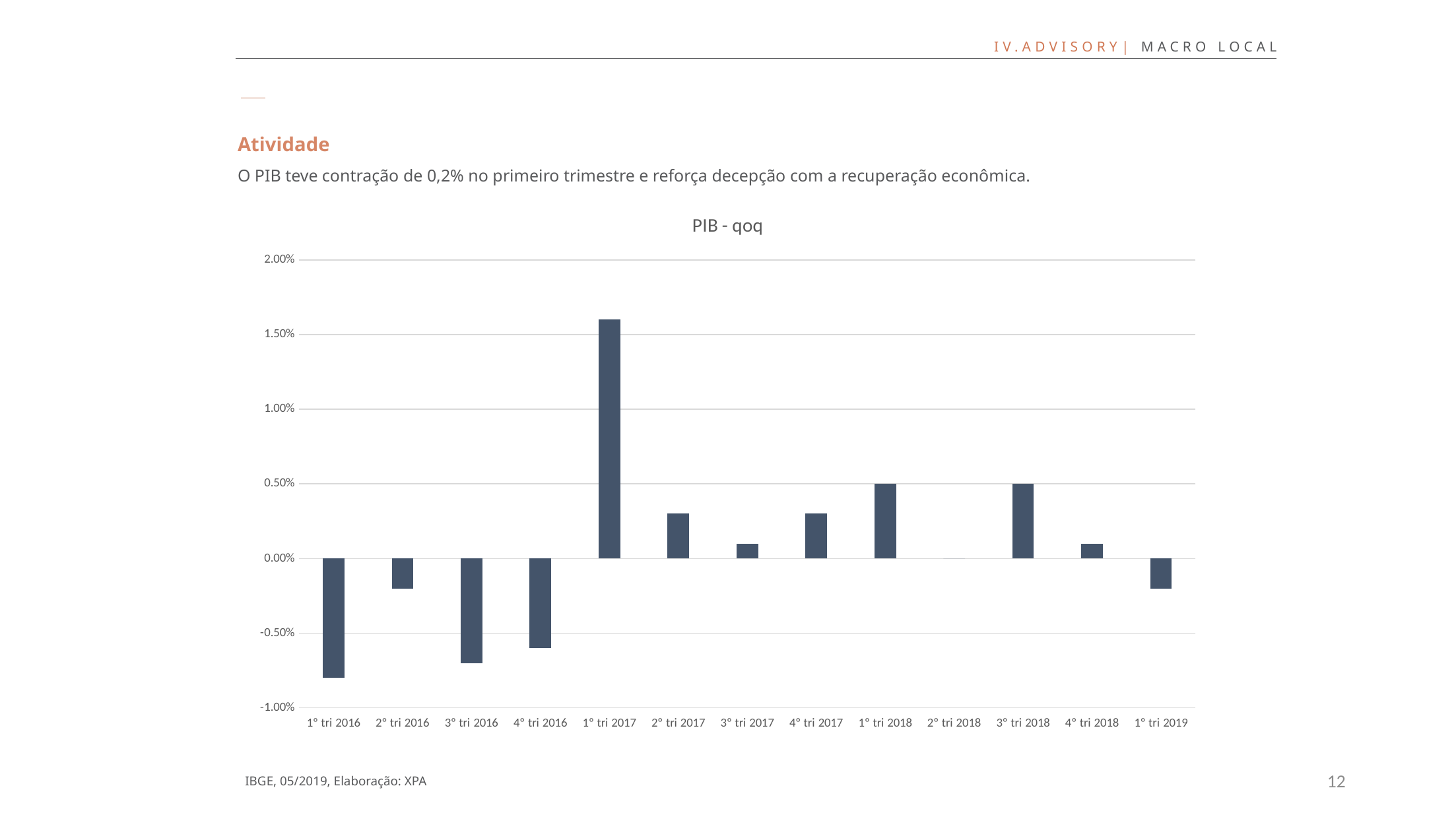
What is the value for 3° tri 2018? 0.50% Is the value for 1° tri 2016 greater or less than -0.50%? less Is the value for 1° tri 2017 greater or less than 1.50%? greater Which is larger, the value for 2° tri 2016 or the value for 3° tri 2016? 2° tri 2016 What type of chart is shown on the slide? bar chart Is the value for 2° tri 2017 greater or less than 0.50%? less What is the title of the chart? PIB - qoq Which quarter has the lowest value in the chart? 1° tri 2016 What is the value for 1° tri 2018? 0.50% Which quarter has the highest value in the chart? 1° tri 2017 Which is larger, the value for 1° tri 2017 or the value for 1° tri 2018? 1° tri 2017 How many quarters are plotted on the x axis of the chart? 13